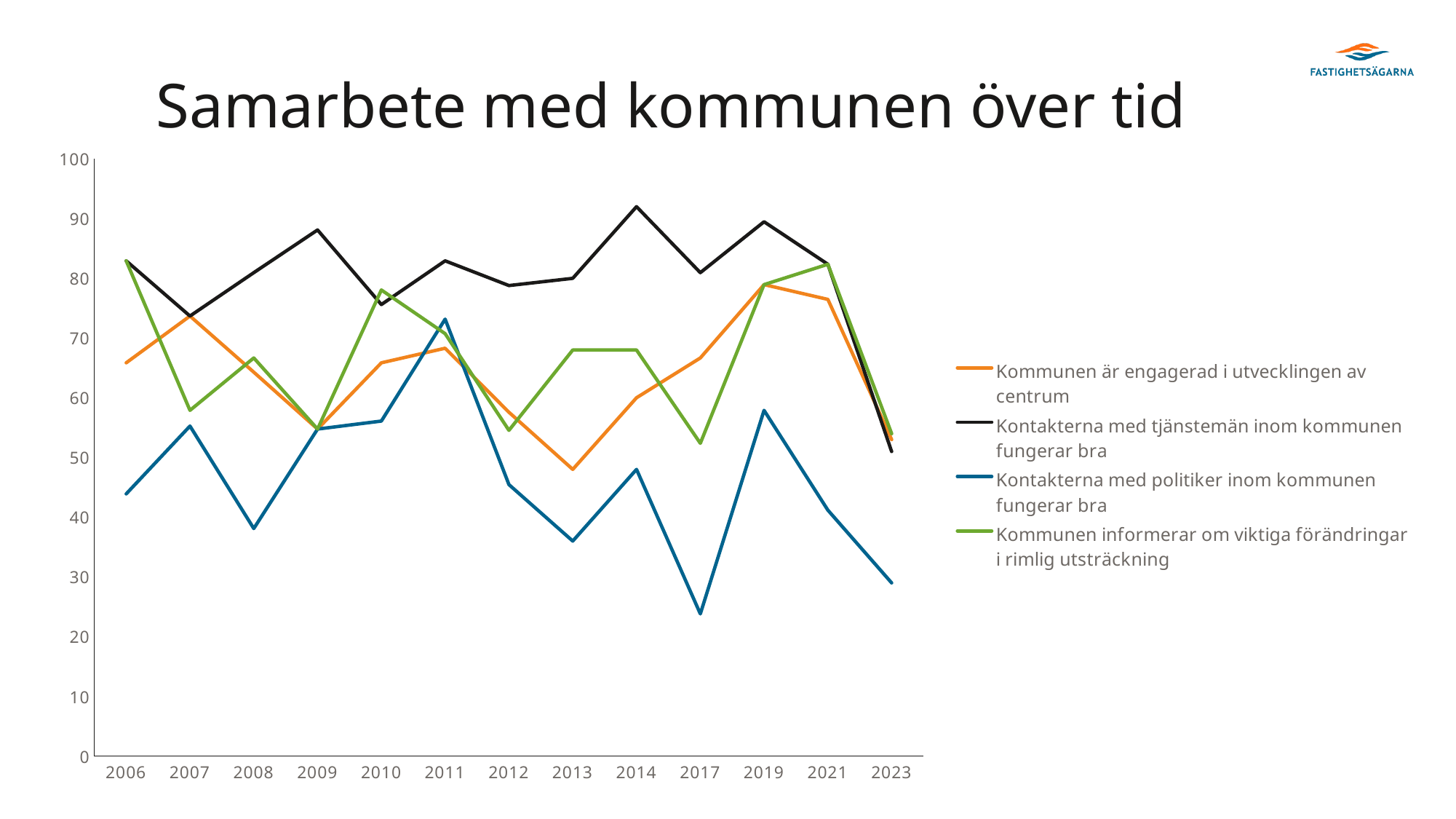
Does the value for "Kontakterna med politiker inom kommunen fungerar bra" rise or fall from 2019 to 2023? fall How many years are shown on the x axis? 13 Is the value for "Kontakterna med politiker inom kommunen fungerar bra" in 2017 greater or less than 30? less In 2008, which is larger: "Kontakterna med tjänstemän inom kommunen fungerar bra" or "Kommunen informerar om viktiga förändringar i rimlig utsträckning"? Kontakterna med tjänstemän inom kommunen fungerar bra In which year does "Kontakterna med politiker inom kommunen fungerar bra" reach its lowest value? 2017 Is the value for "Kommunen är engagerad i utvecklingen av centrum" in 2013 greater or less than 50? less What kind of chart is shown on the slide? line chart How many series does the legend list? 4 In which year does "Kontakterna med tjänstemän inom kommunen fungerar bra" reach its highest value? 2014 What colour is the line for "Kontakterna med politiker inom kommunen fungerar bra"? blue Is the value for "Kontakterna med tjänstemän inom kommunen fungerar bra" in 2014 greater or less than 90? greater In 2023, which is larger: "Kommunen är engagerad i utvecklingen av centrum" or "Kontakterna med politiker inom kommunen fungerar bra"? Kommunen är engagerad i utvecklingen av centrum